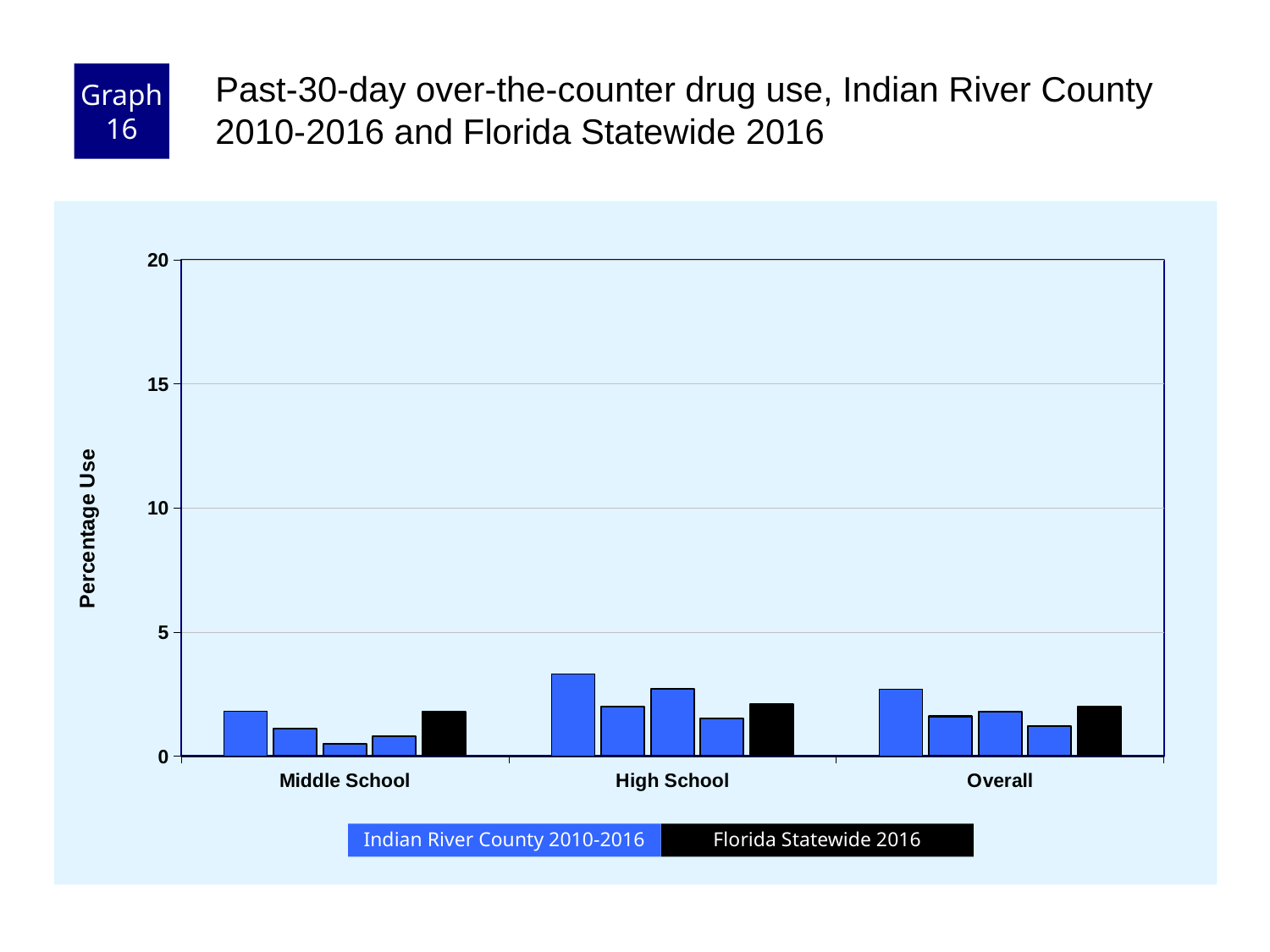
Is the Florida Statewide 2016 value for Middle School greater or less than 5? less Is the Florida Statewide 2016 value for High School larger or smaller than the tallest Indian River County bar in the High School group? smaller What is the label on the y axis? Percentage Use Is the Florida Statewide 2016 value for High School greater or less than 5? less Which category contains the shortest bar in the chart? Middle School Is the Florida Statewide 2016 value for Overall greater or less than 10? less What colour represents Florida Statewide 2016 in the legend? black Which category contains the tallest bar in the chart? High School How many categories are shown along the x axis? 3 What kind of chart is shown on the slide? bar chart How many series does the legend list? 2